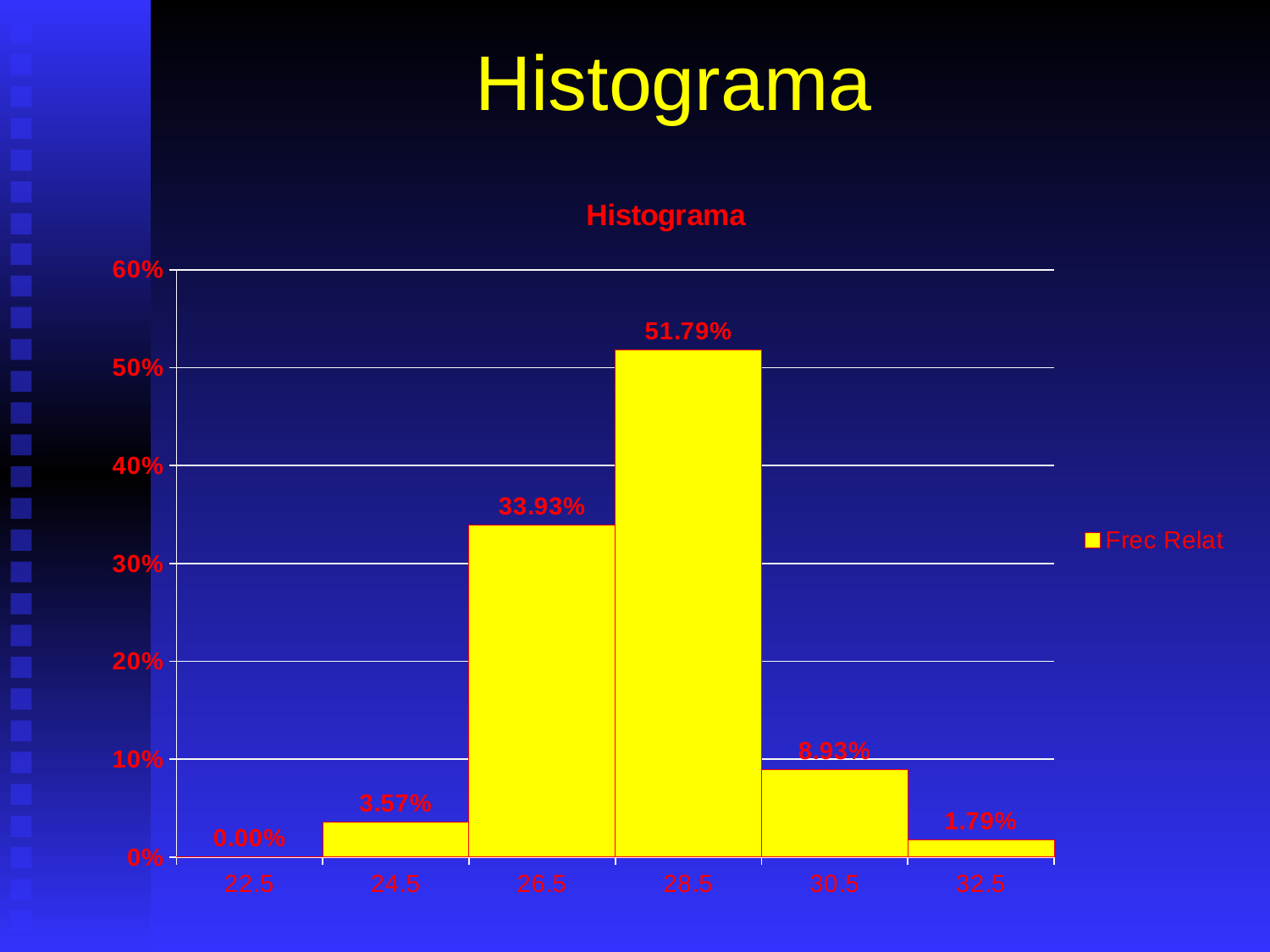
What is the name of the series in the legend? Frec Relat Which category has the highest value? 28.5 What is the value for 22.5? 0.00% What is the value for 30.5? 8.93% What kind of chart is shown? bar chart How many series does the legend list? 1 What is the difference between the values for 28.5 and 26.5? 17.86% How many categories are shown on the x axis? 6 Which category has the lowest value? 22.5 What is the value for 26.5? 33.93% What is the value for 28.5? 51.79% Which is larger, the value for 24.5 or the value for 32.5? 24.5